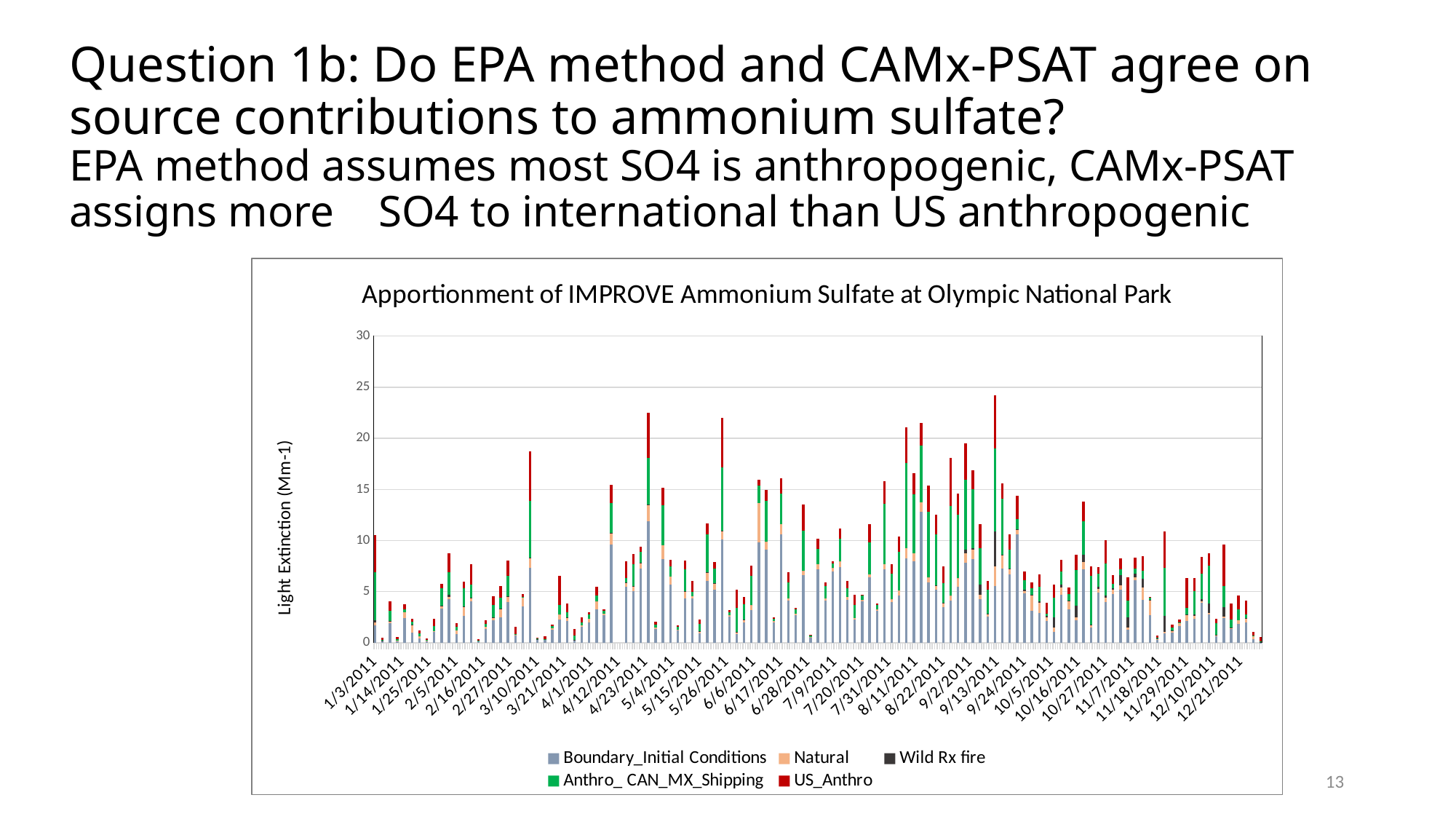
Is the tallest bar in the chart greater or less than 25? less How many series does the legend list? 5 Is the tallest bar in the chart greater or less than 20? greater Is the total for the first bar, at 1/3/2011, greater or less than 15? less What is the label of the vertical axis? Light Extinction (Mm-1) What kind of chart is shown on the slide? Stacked bar chart What is the title of the chart? Apportionment of IMPROVE Ammonium Sulfate at Olympic National Park